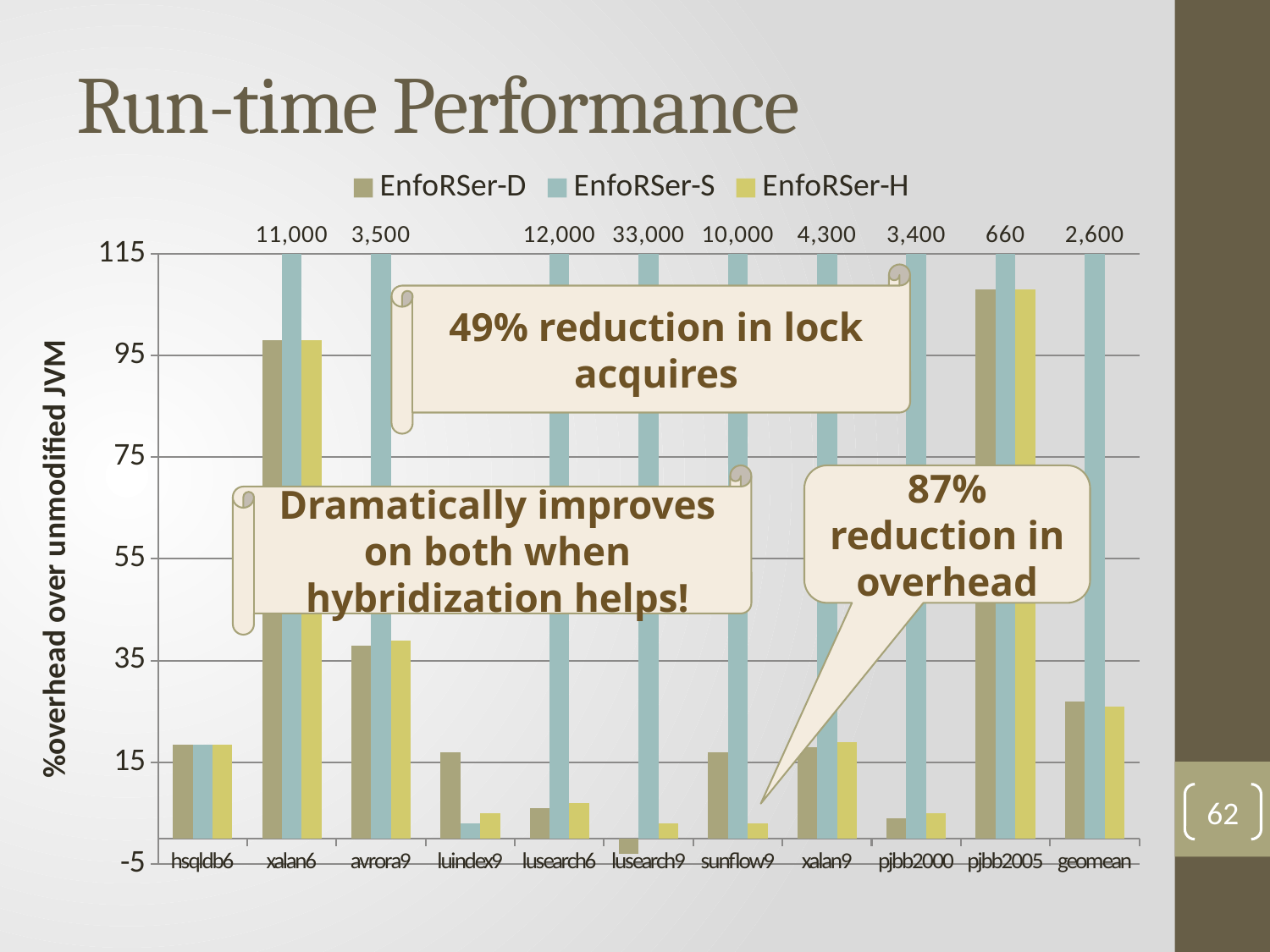
What kind of chart is shown on the slide? bar chart For luindex9, which is larger: the EnfoRSer-D bar or the EnfoRSer-H bar? EnfoRSer-D How many series does the legend list? 3 Is the EnfoRSer-H value for geomean greater or less than 35? less What is the label on the y axis? %overhead over unmodified JVM What value is printed above the EnfoRSer-S bar for pjbb2005? 660 Is the EnfoRSer-D value for pjbb2005 greater or less than 95? greater How many benchmark categories are shown along the x axis? 11 What is the difference between the printed EnfoRSer-S values for lusearch9 and xalan6? 22,000 What value is printed above the EnfoRSer-S bar for lusearch9? 33,000 Which category has the lowest printed EnfoRSer-S value? pjbb2005 Which category has the highest printed EnfoRSer-S value? lusearch9